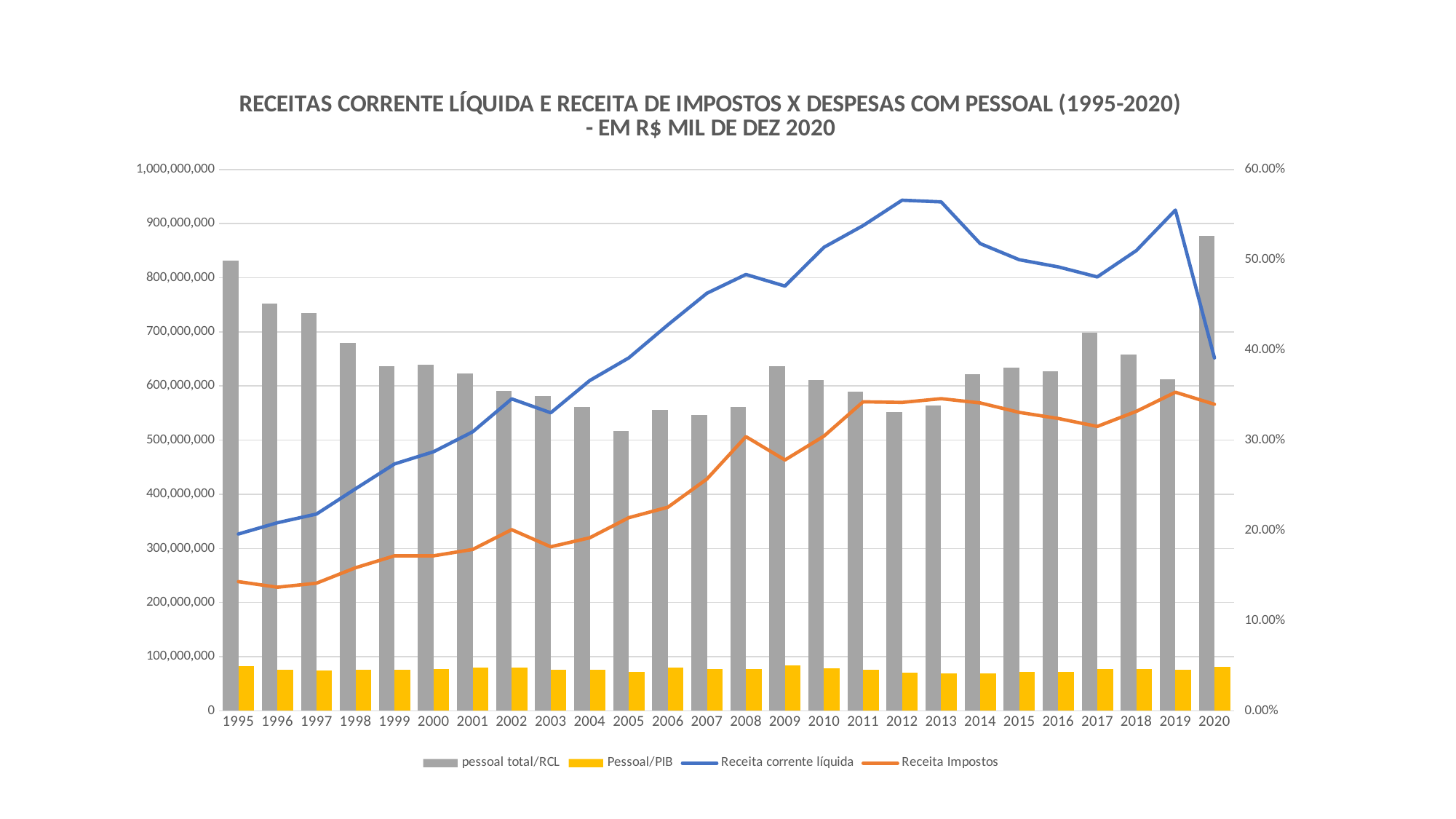
Is the value for Receita Impostos in 2019 greater or less than 500,000,000? greater Is the value for Receita corrente líquida in 2012 greater or less than 900,000,000? greater Is the value for Pessoal/PIB in 2009 greater or less than 10.00%? less What kind of chart is shown on the slide? Combination bar and line chart Which year has the lowest value for pessoal total/RCL? 2005 How many series does the legend list? 4 Does Receita Impostos generally rise or fall from 1995 to 2020? Rise Which year has the lowest value for Receita corrente líquida? 1995 Which year has the highest value for pessoal total/RCL? 2020 How many years are shown on the x axis? 26 Which is larger, Receita corrente líquida in 2019 or in 2020? 2019